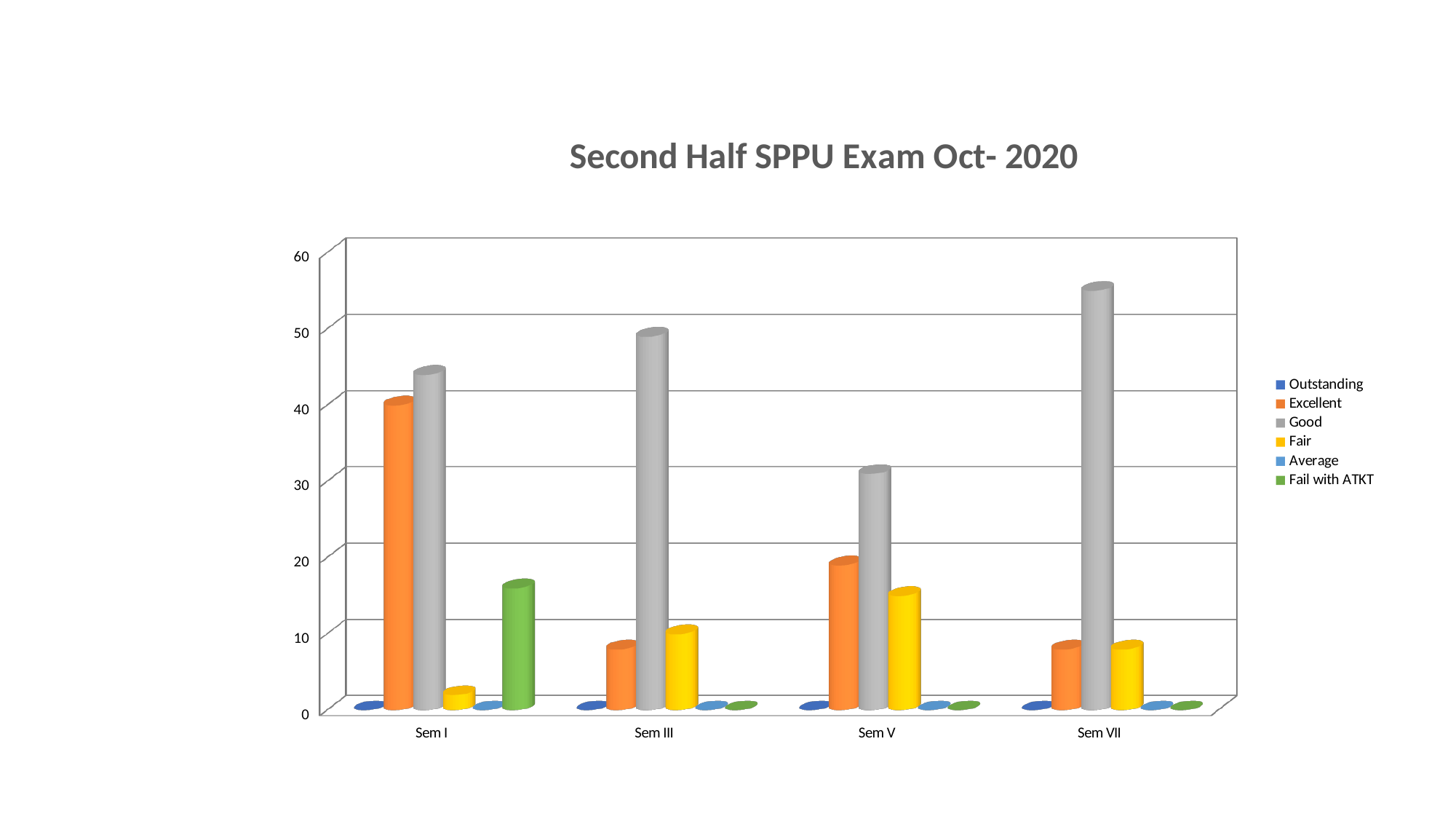
Is the value for Good in Sem VII greater or less than 50? greater Is the value for Excellent in Sem I greater or less than 30? greater What kind of chart is shown on the slide? bar chart Which semester has the highest value for Good? Sem VII Which is larger: Fair in Sem V or Fair in Sem VII? Sem V Which series has the highest value in Sem III? Good Which semester has the lowest value for Good? Sem V Is the value for Good in Sem V greater or less than 40? less How many semester categories are shown on the x axis? 4 How many series does the legend list? 6 What is the title of the chart? Second Half SPPU Exam Oct- 2020 Which is larger: Excellent in Sem I or Excellent in Sem III? Sem I